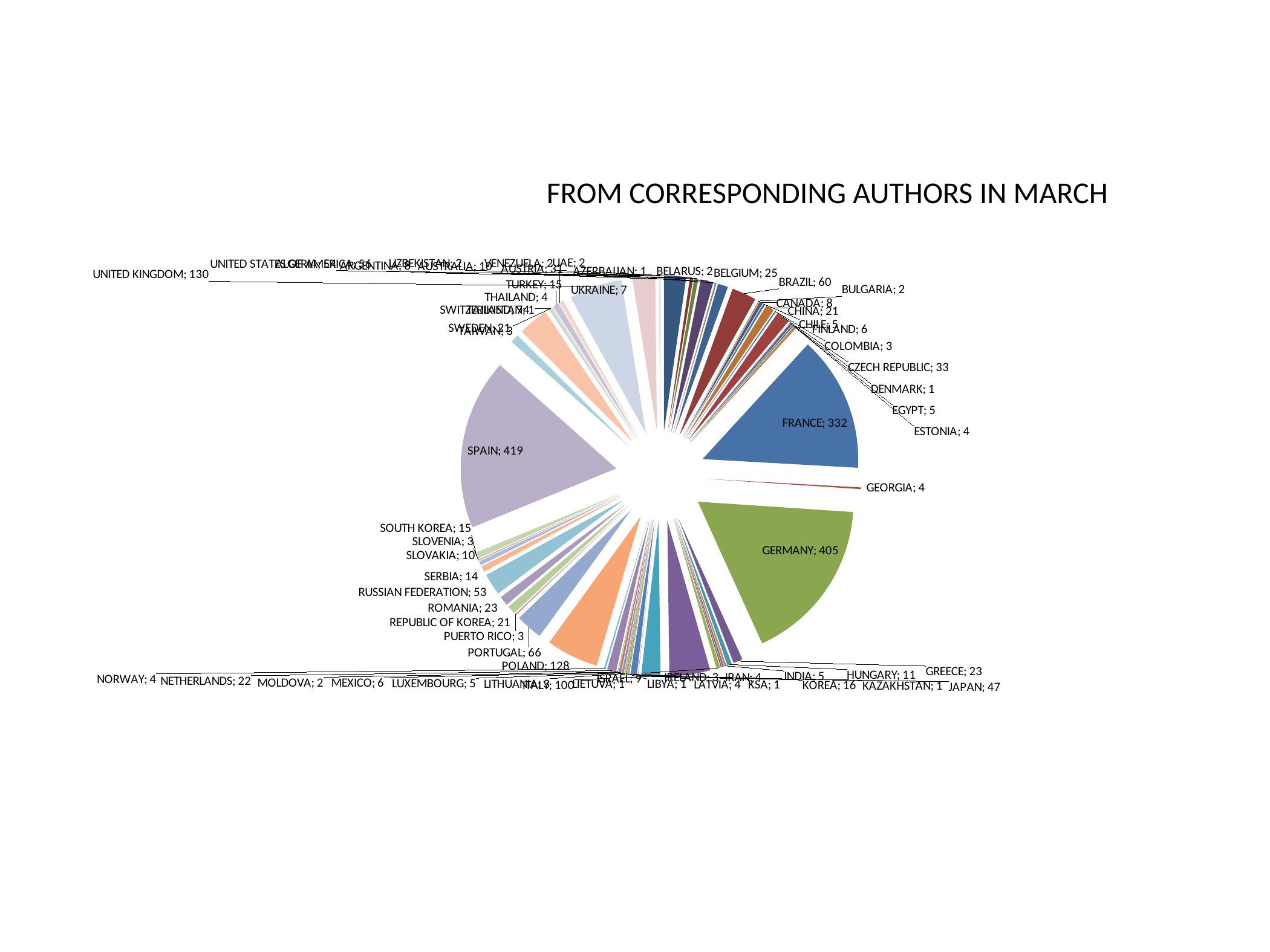
What is the difference between the values for SPAIN and GERMANY? 14 What is the difference between the values for FRANCE and UNITED KINGDOM? 202 Which country has the largest slice in the pie chart? SPAIN What is the value for UNITED KINGDOM? 130 What is the value for CZECH REPUBLIC? 33 Which is larger, the value for FRANCE or the value for UNITED KINGDOM? FRANCE What is the title of the chart? FROM CORRESPONDING AUTHORS IN MARCH What is the value for FRANCE? 332 What is the value for POLAND? 128 What kind of chart is shown on the slide? pie chart What is the value for SPAIN? 419 What is the value for GERMANY? 405